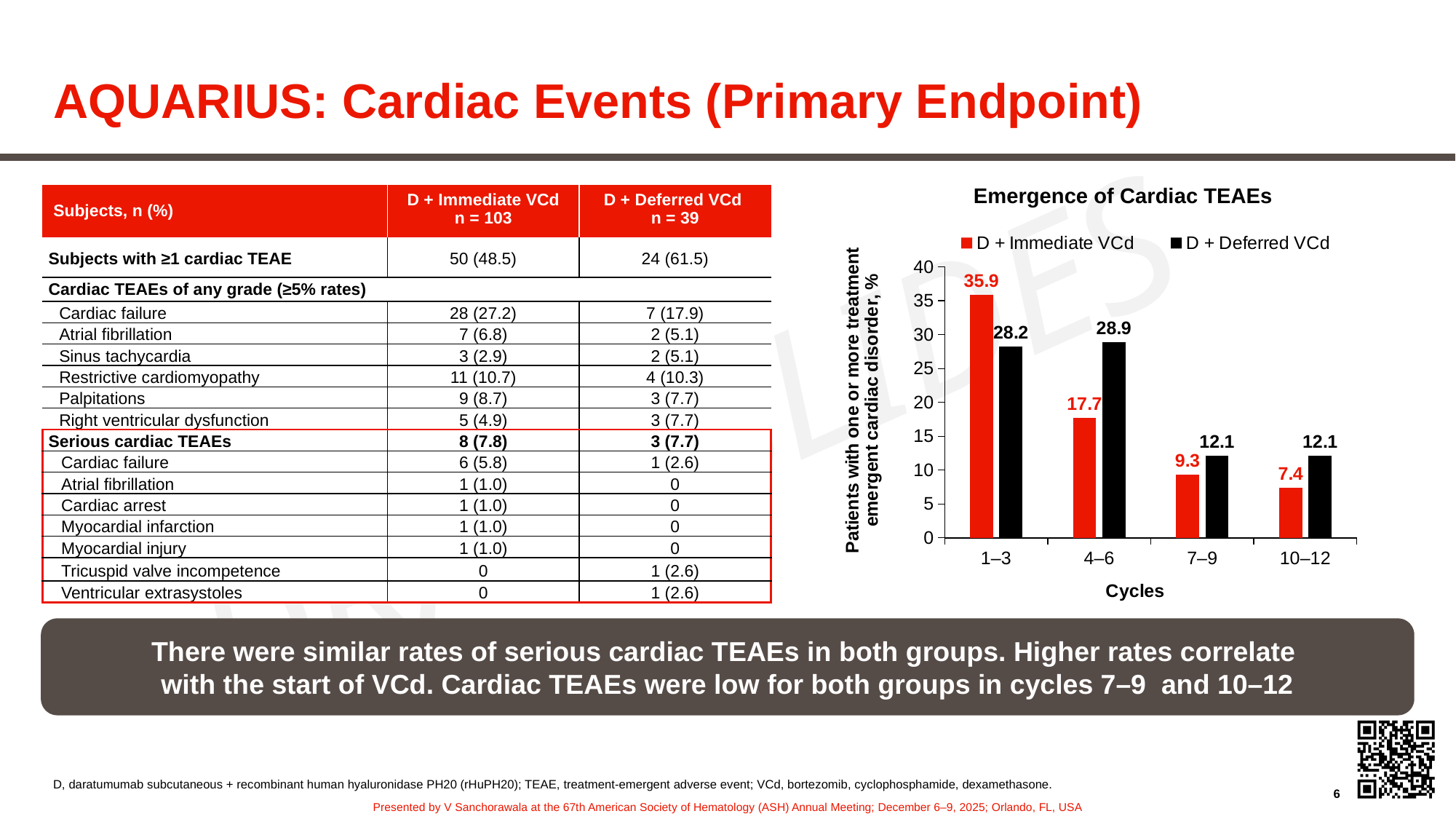
How many series does the legend list? 2 What is the value for D + Deferred VCd in cycles 4–6? 28.9 What is the value for D + Immediate VCd in cycles 1–3? 35.9 In which cycle group is the D + Immediate VCd value lowest? 10–12 Which series has the larger value in cycles 1–3? D + Immediate VCd What is the value for D + Immediate VCd in cycles 10–12? 7.4 Do the D + Immediate VCd values rise or fall across the cycle groups from 1–3 to 10–12? Fall How many cycle groups are shown on the x axis? 4 What is the difference between D + Deferred VCd and D + Immediate VCd in cycles 4–6? 11.2 Is the value for D + Deferred VCd in cycles 7–9 greater or less than 10? greater What kind of chart is shown? Bar chart In which cycle group is the D + Immediate VCd value highest? 1–3